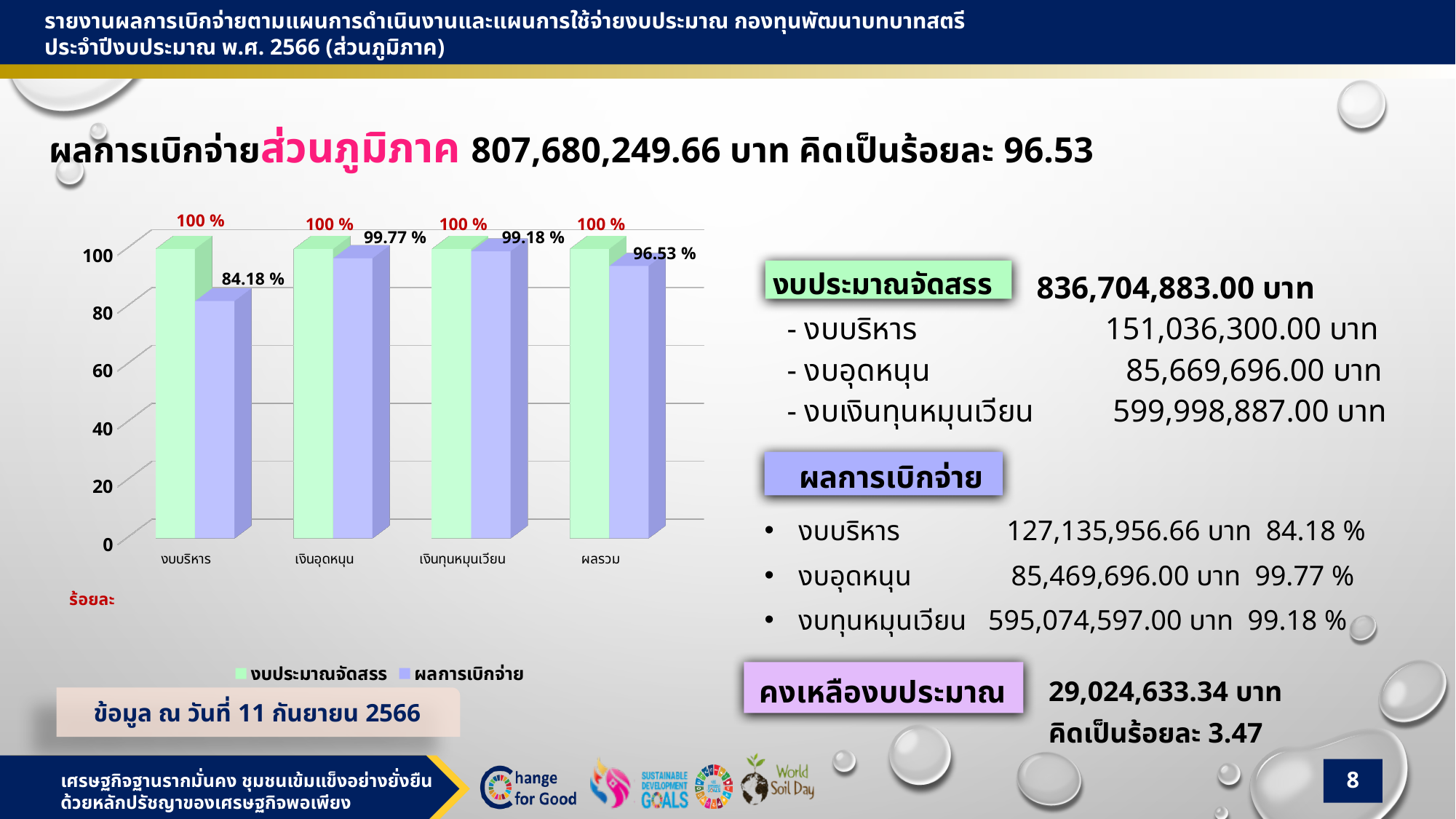
What is the ผลการเบิกจ่าย value for เงินอุดหนุน in the chart? 99.77 % How many categories are shown on the x axis of the chart? 4 Which category has the highest ผลการเบิกจ่าย value in the chart? เงินอุดหนุน What is the ผลการเบิกจ่าย value for เงินทุนหมุนเวียน in the chart? 99.18 % How many series does the chart legend list? 2 What type of chart is shown on the slide? bar chart What is the ผลการเบิกจ่าย value for งบบริหาร in the chart? 84.18 % What is the งบประมาณจัดสรร value for งบบริหาร in the chart? 100 % What is the ผลการเบิกจ่าย value for ผลรวม in the chart? 96.53 % Which series is shown in green in the chart legend? งบประมาณจัดสรร Which category has the lowest ผลการเบิกจ่าย value in the chart? งบบริหาร What is the difference between the งบประมาณจัดสรร and ผลการเบิกจ่าย values for งบบริหาร in the chart? 15.82 %